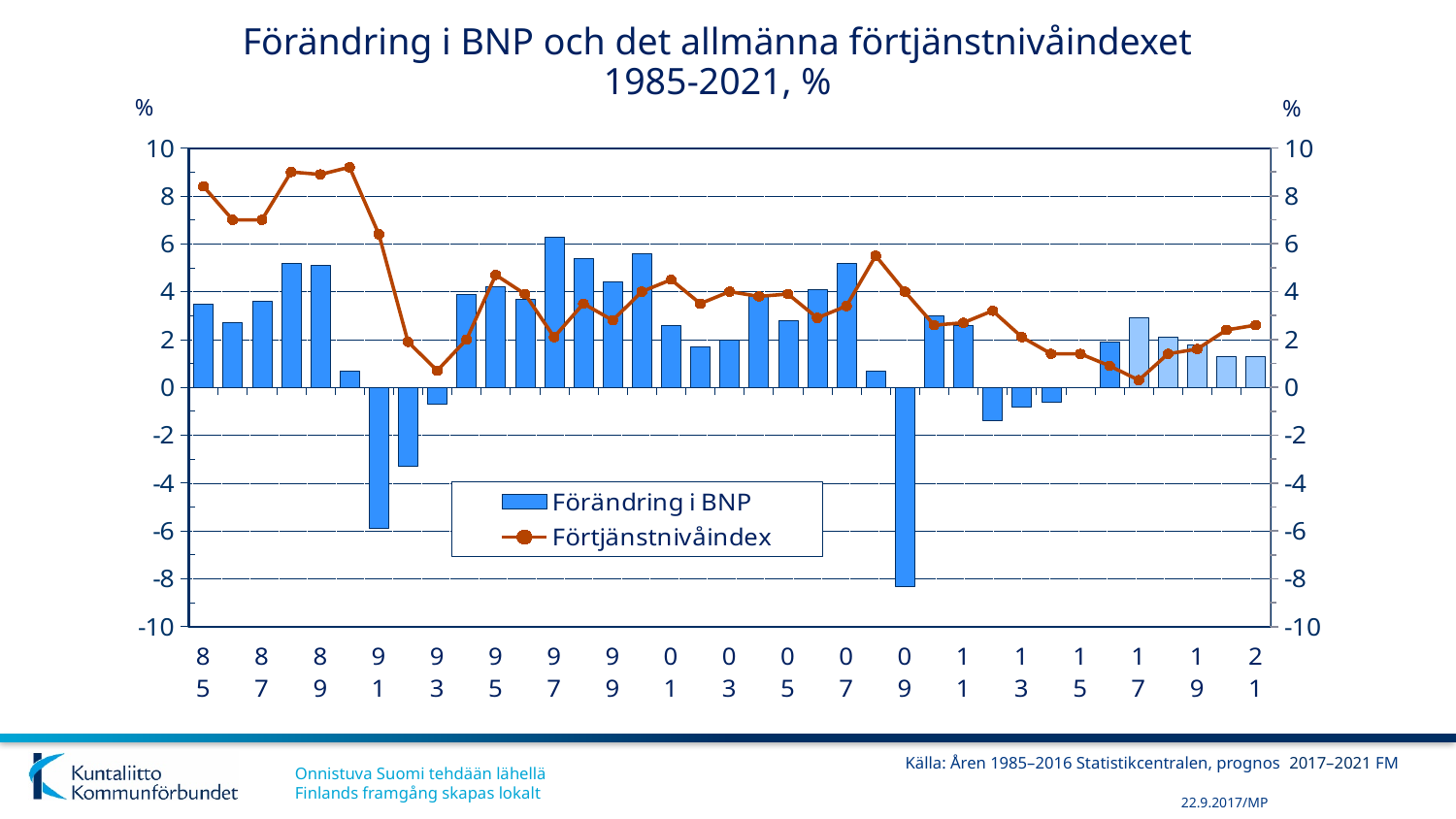
Which is larger, the Förtjänstnivåindex value for 1985 or for 1987? 1985 Is the Förtjänstnivåindex value for 1989 greater or less than 8? greater Is the Förändring i BNP value for 2009 greater or less than -6? less What is the title of the chart? Förändring i BNP och det allmänna förtjänstnivåindexet 1985-2021, % Is the Förtjänstnivåindex value for 2017 greater or less than 2? less In which year is the Förändring i BNP bar lowest? 2009 Which series is drawn as a line with markers? Förtjänstnivåindex How many series does the legend list? 2 Does the Förtjänstnivåindex line rise or fall overall from 1985 to 1993? fall What kind of chart is shown on the slide? Combined bar and line chart In which year is the Förändring i BNP bar highest? 1997